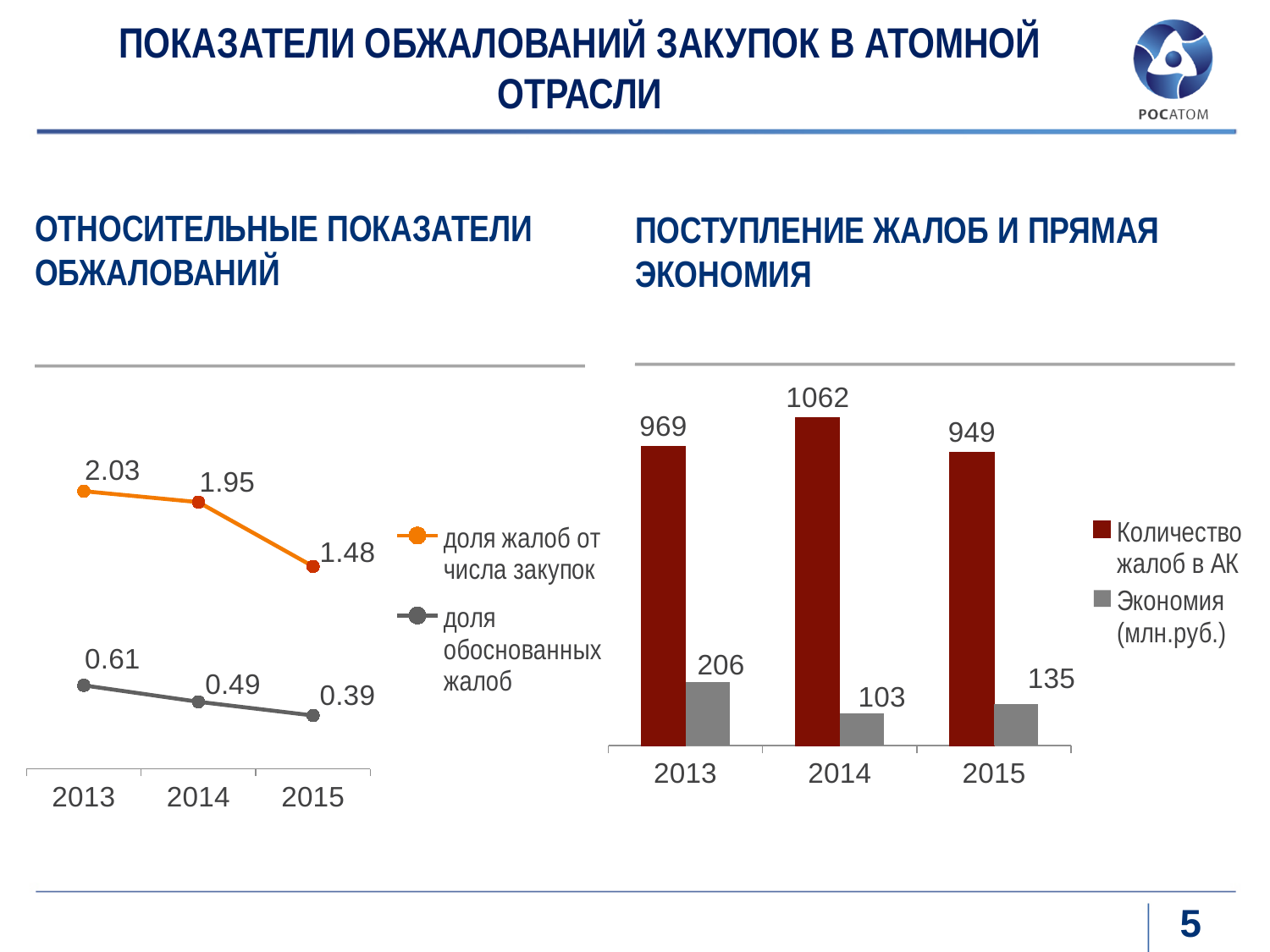
In the left chart (ОТНОСИТЕЛЬНЫЕ ПОКАЗАТЕЛИ ОБЖАЛОВАНИЙ), what is the value of 'доля жалоб от числа закупок' in 2013? 2.03 In the left chart (ОТНОСИТЕЛЬНЫЕ ПОКАЗАТЕЛИ ОБЖАЛОВАНИЙ), how many series does the legend list? 2 In the right chart (ПОСТУПЛЕНИЕ ЖАЛОБ И ПРЯМАЯ ЭКОНОМИЯ), what kind of chart is it? bar chart In the right chart (ПОСТУПЛЕНИЕ ЖАЛОБ И ПРЯМАЯ ЭКОНОМИЯ), what is the value of 'Количество жалоб в АК' in 2014? 1062 In the right chart (ПОСТУПЛЕНИЕ ЖАЛОБ И ПРЯМАЯ ЭКОНОМИЯ), which year has the lowest 'Экономия (млн.руб.)'? 2014 In the right chart (ПОСТУПЛЕНИЕ ЖАЛОБ И ПРЯМАЯ ЭКОНОМИЯ), what is the difference between 'Экономия (млн.руб.)' in 2013 and 2014? 103 In the right chart (ПОСТУПЛЕНИЕ ЖАЛОБ И ПРЯМАЯ ЭКОНОМИЯ), which year has the highest 'Количество жалоб в АК'? 2014 In the left chart (ОТНОСИТЕЛЬНЫЕ ПОКАЗАТЕЛИ ОБЖАЛОВАНИЙ), what is the value of 'доля обоснованных жалоб' in 2015? 0.39 In the left chart (ОТНОСИТЕЛЬНЫЕ ПОКАЗАТЕЛИ ОБЖАЛОВАНИЙ), does 'доля жалоб от числа закупок' rise or fall from 2013 to 2015? fall In the left chart (ОТНОСИТЕЛЬНЫЕ ПОКАЗАТЕЛИ ОБЖАЛОВАНИЙ), what kind of chart is it? line chart In the right chart (ПОСТУПЛЕНИЕ ЖАЛОБ И ПРЯМАЯ ЭКОНОМИЯ), what is the value of 'Экономия (млн.руб.)' in 2015? 135 In the left chart (ОТНОСИТЕЛЬНЫЕ ПОКАЗАТЕЛИ ОБЖАЛОВАНИЙ), what is the difference between 'доля жалоб от числа закупок' in 2013 and 2015? 0.55